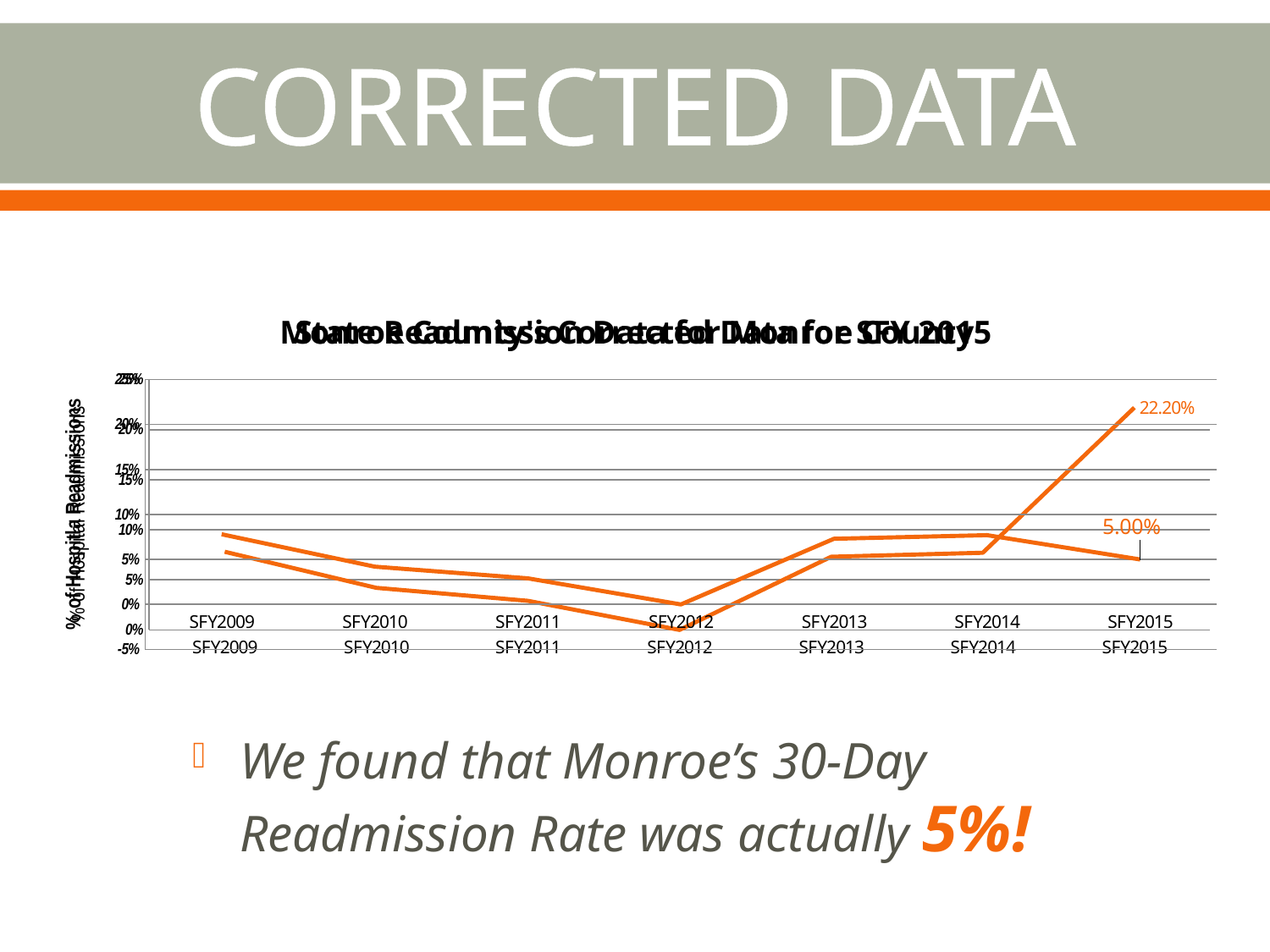
What kind of chart is shown on the slide? line chart What is the last category on the x axis of the chart? SFY2015 Is the value labelled 22.20% at SFY2015 greater or less than 20%? greater At SFY2015, which labelled value is larger, 22.20% or 5.00%? 22.20% What value is labelled at SFY2015 on the line that rises sharply at the end of the chart? 22.20% What is the difference between the two labelled SFY2015 values on the chart (22.20% and 5.00%)? 17.20% What is the first category on the x axis of the chart? SFY2009 Is the value labelled 5.00% at SFY2015 greater or less than 10%? less How many fiscal-year categories are shown along the x axis of the chart? 7 Does the line ending at 22.20% rise or fall between SFY2014 and SFY2015? rise Does the line ending at 5.00% rise or fall between SFY2014 and SFY2015? fall What value is labelled at SFY2015 on the lower line of the chart? 5.00%